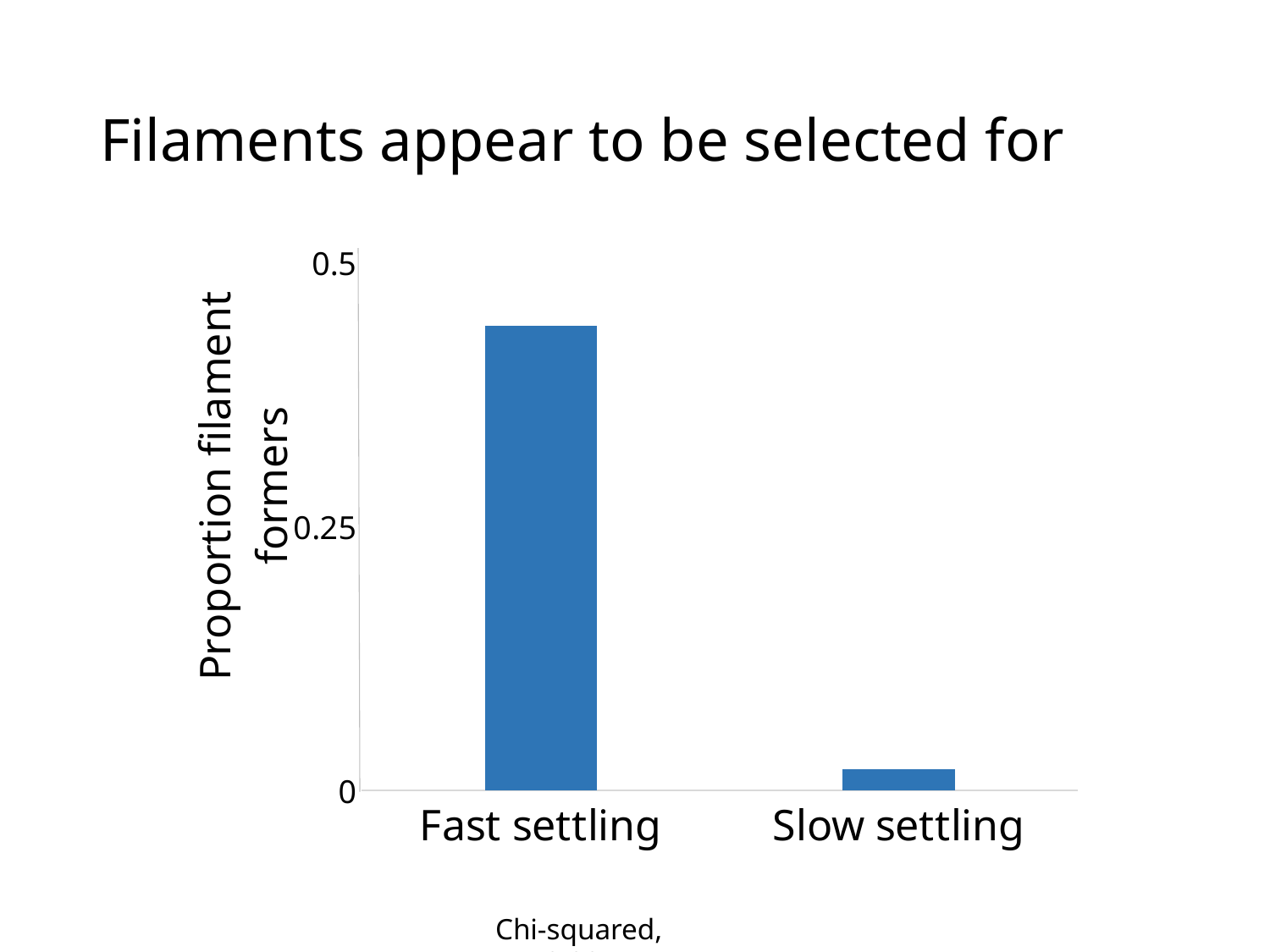
Is the value for Slow settling greater or less than 0.25? less Which is larger, the value for Fast settling or the value for Slow settling? Fast settling Is the value for Fast settling greater or less than 0.25? greater How many categories are plotted on the x axis? 2 What kind of chart is shown on the slide? bar chart Do the values rise or fall from Fast settling to Slow settling? fall What is the title of the slide? Filaments appear to be selected for Which category has the lowest proportion of filament formers? Slow settling Which category has the highest proportion of filament formers? Fast settling Is the value for Fast settling greater or less than 0.5? less What is the label of the y axis? Proportion filament formers